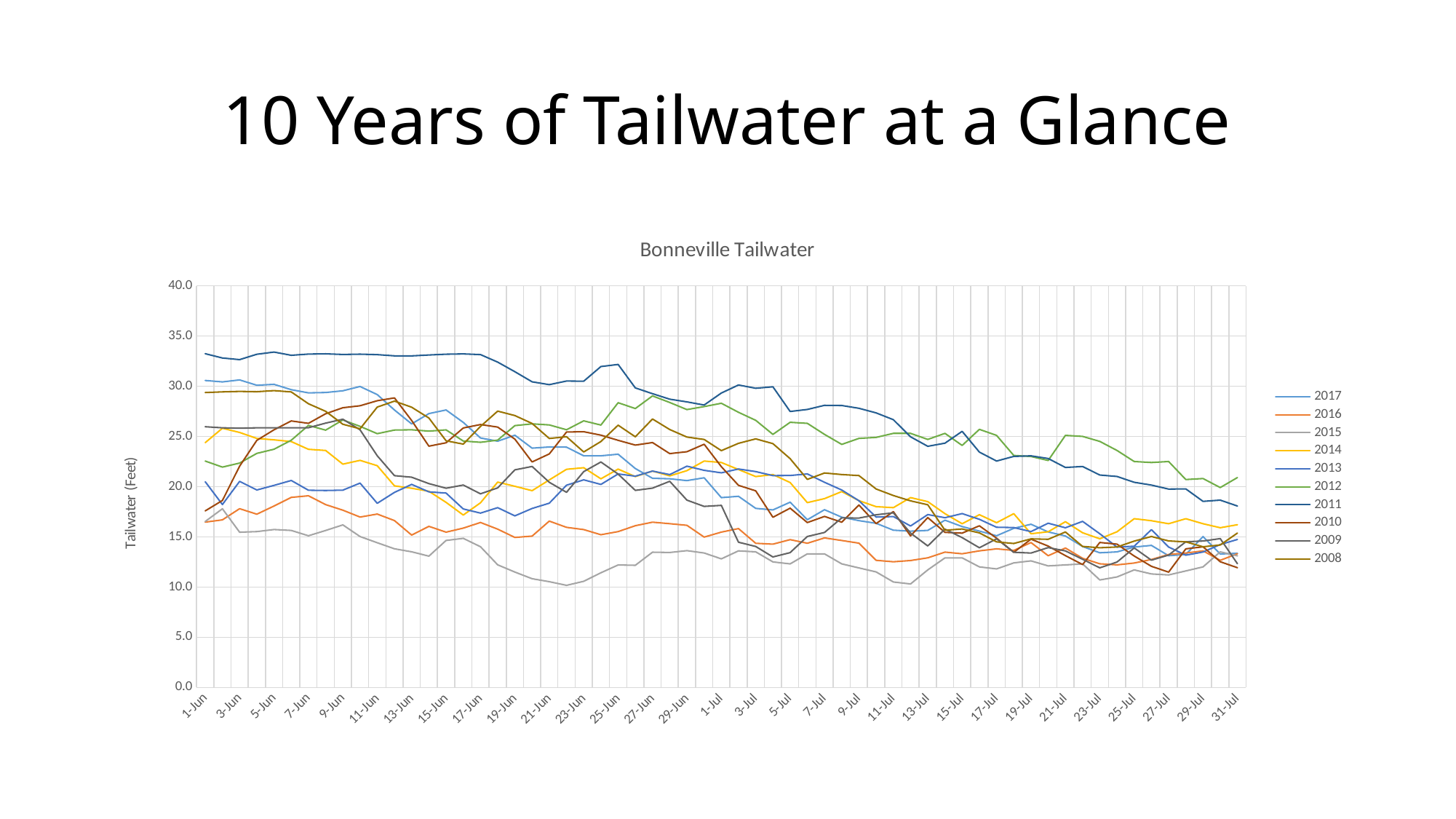
Is the value for 2011 on 31-Jul greater or less than 20.0? less Does the 2011 series generally rise or fall from 1-Jun to 31-Jul? fall On 1-Jul, which is larger: the value for 2011 or the value for 2015? 2011 What is the title of the chart? Bonneville Tailwater How many series does the legend of the Bonneville Tailwater chart list? 10 Is the value for 2016 on 1-Jun greater or less than 20.0? less Is the value for 2011 on 1-Jun greater or less than 30.0? greater What kind of chart is shown on the slide? line chart Which year's series has the lowest value on 23-Jun? 2015 What is the label of the vertical axis? Tailwater (Feet) Which year's series has the highest value on 1-Jun? 2011